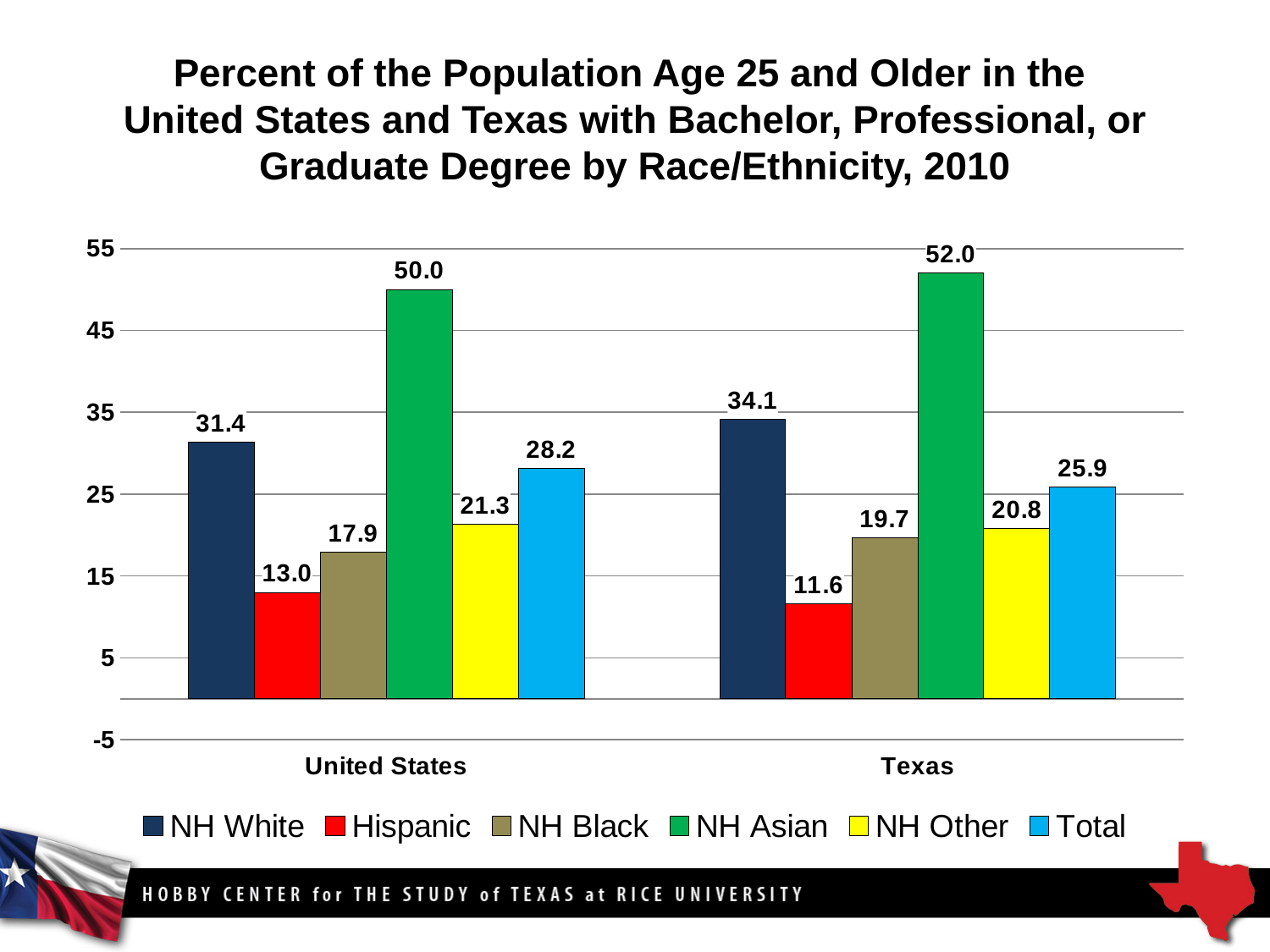
How many categories are shown on the x axis? 2 What is the Total value for Texas? 25.9 Which series has the highest value in the United States group? NH Asian Which is larger, the NH Black value for the United States or for Texas? Texas How many series does the legend list? 6 Which series has the lowest value in the Texas group? Hispanic What colour are the NH Asian bars? green What kind of chart is shown on the slide? bar chart What is the difference between the NH White values for Texas and the United States? 2.7 What is the value for NH Asian in Texas? 52.0 What is the value for Hispanic in the United States? 13.0 Is the value for NH Other in the United States greater or less than 25? less